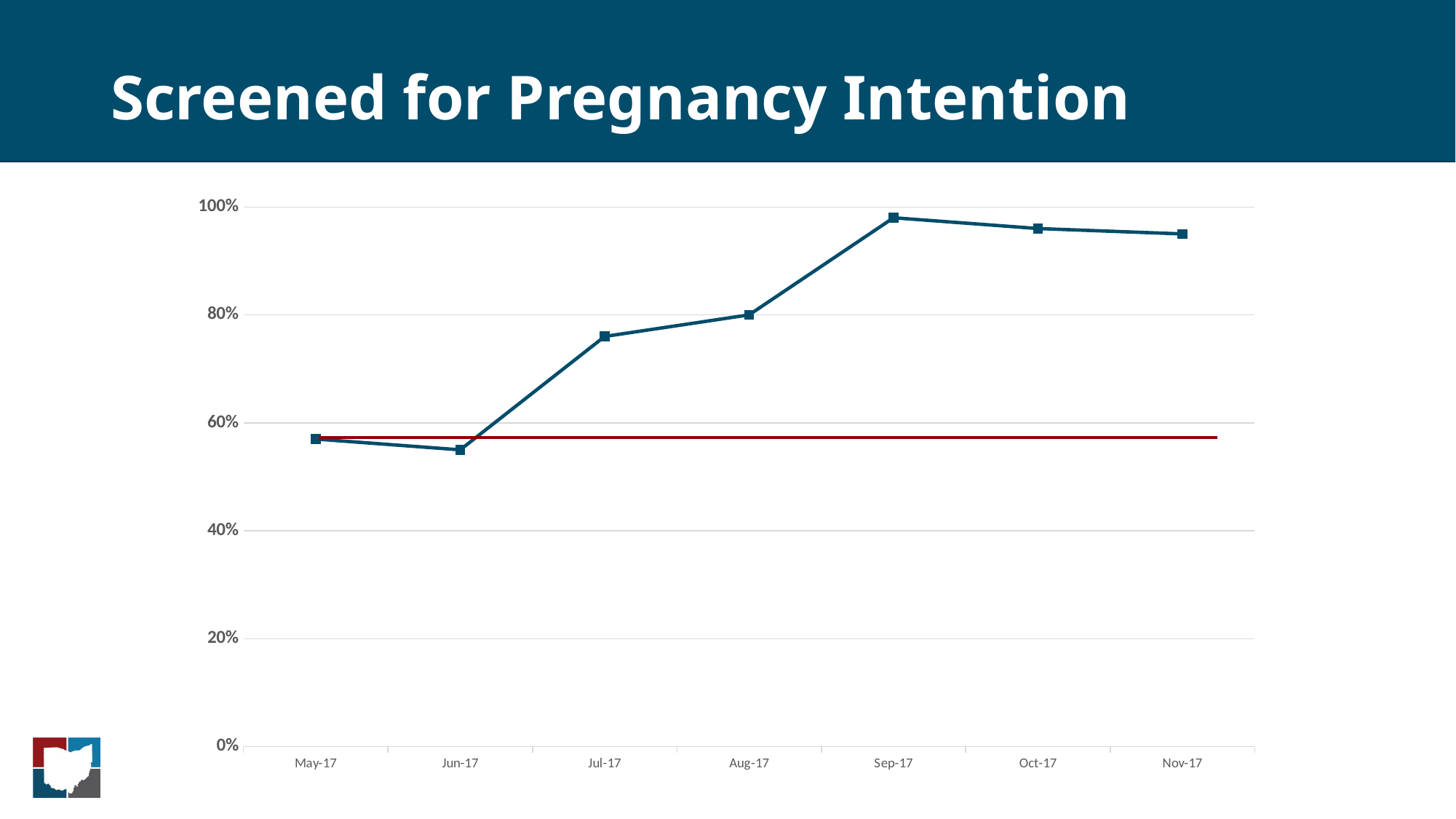
What is the value for Aug-17? 80% Which month has the lowest screening percentage? Jun-17 Is the value for Jul-17 greater or less than 60%? greater What is the title of the chart on the slide? Screened for Pregnancy Intention How many months are plotted along the x axis? 7 Is the value for Sep-17 greater or less than 80%? greater Which is larger, the value for Jul-17 or the value for Aug-17? Aug-17 Overall, do the values rise or fall from May-17 to Nov-17? rise Is the value for May-17 greater or less than 60%? less What kind of chart is shown on the slide? line chart Which month has the highest screening percentage? Sep-17